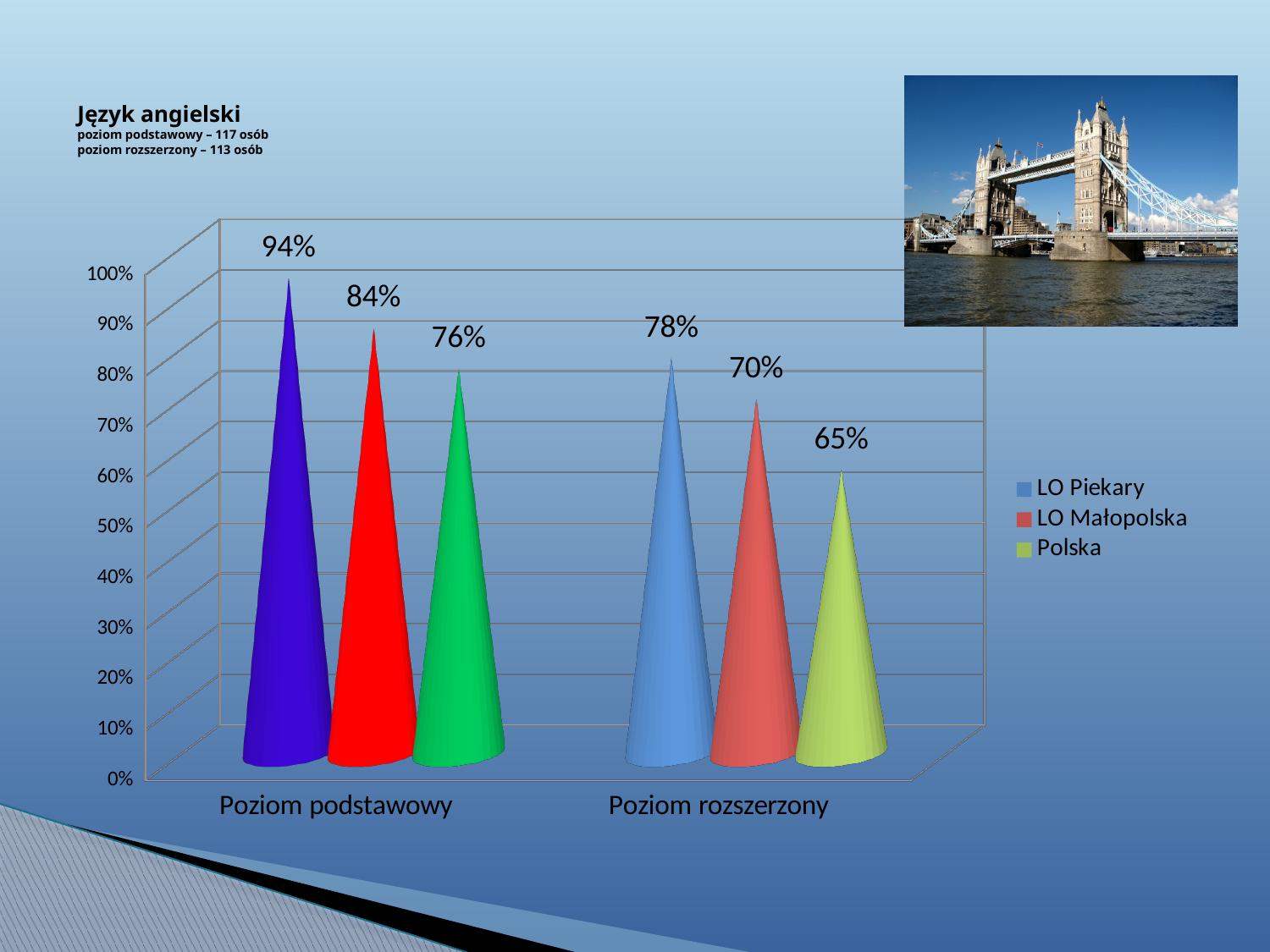
Which series has the highest value at Poziom podstawowy? LO Piekary What is the value for LO Małopolska at Poziom podstawowy? 84% Which series has the lowest value at Poziom rozszerzony? Polska What is the difference between LO Małopolska at Poziom podstawowy and at Poziom rozszerzony? 14% How many categories are shown on the x axis? 2 What is the value for LO Piekary at Poziom rozszerzony? 78% What kind of chart is shown on the slide? Bar chart What is the difference between LO Piekary and Polska at Poziom podstawowy? 18% What is the value for Polska at Poziom rozszerzony? 65% Which is larger: LO Małopolska at Poziom rozszerzony or Polska at Poziom podstawowy? Polska at Poziom podstawowy What is the value for LO Piekary at Poziom podstawowy? 94% How many series does the legend list? 3